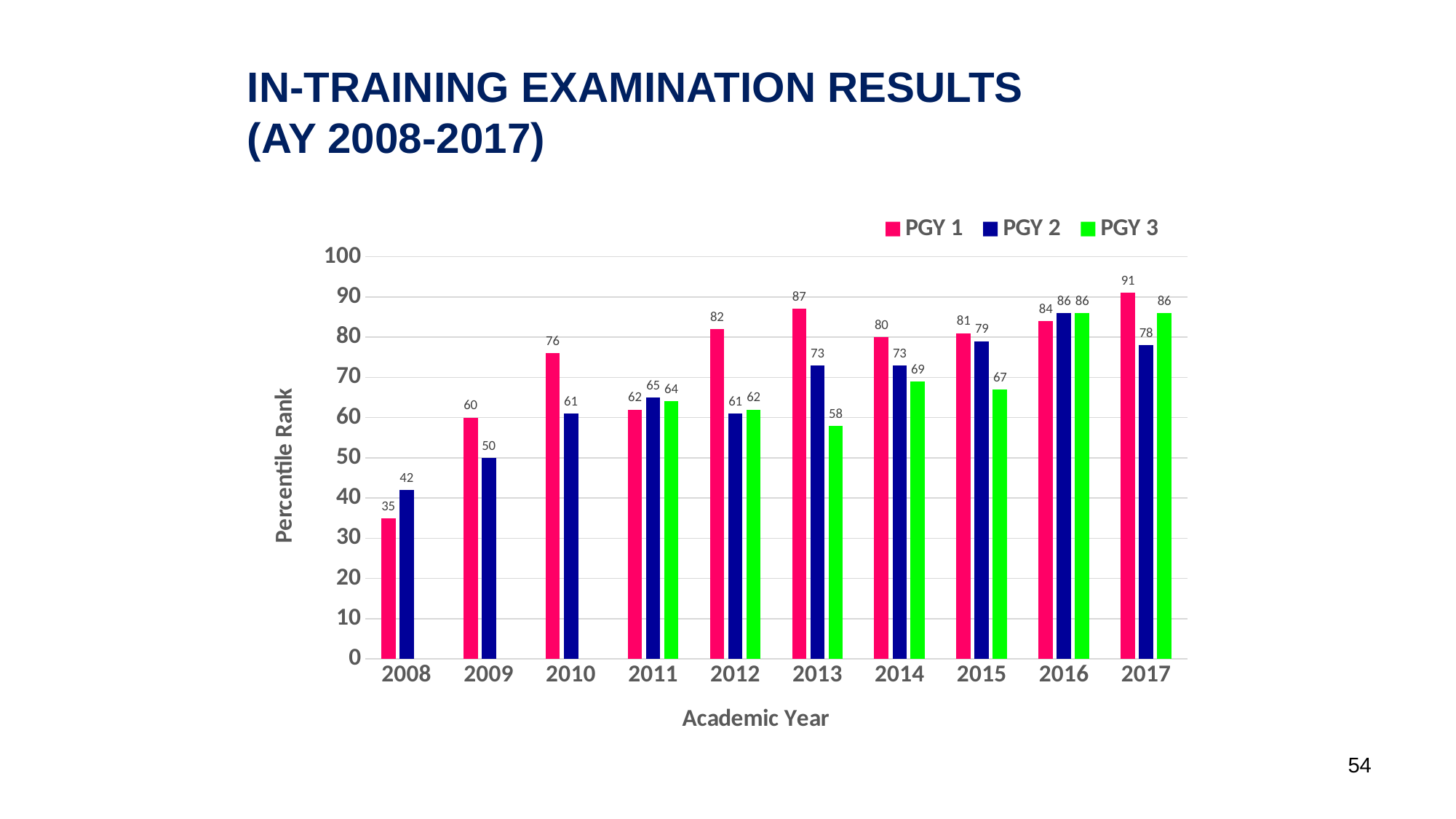
What kind of chart is shown on the slide? Bar chart What is the PGY 1 percentile rank for 2013? 87 What is the PGY 2 percentile rank for 2009? 50 How many series does the legend list? 3 Which is larger in 2017, the PGY 2 or the PGY 3 percentile rank? PGY 3 Does the PGY 1 percentile rank generally rise or fall from 2008 to 2017? Rise What is the label of the y axis? Percentile Rank How many academic years are shown on the x axis? 10 Which academic year has the highest PGY 1 percentile rank? 2017 What is the PGY 3 percentile rank for 2015? 67 Which academic year has the lowest PGY 3 percentile rank? 2013 What is the difference between the PGY 1 and PGY 3 percentile ranks in 2013? 29